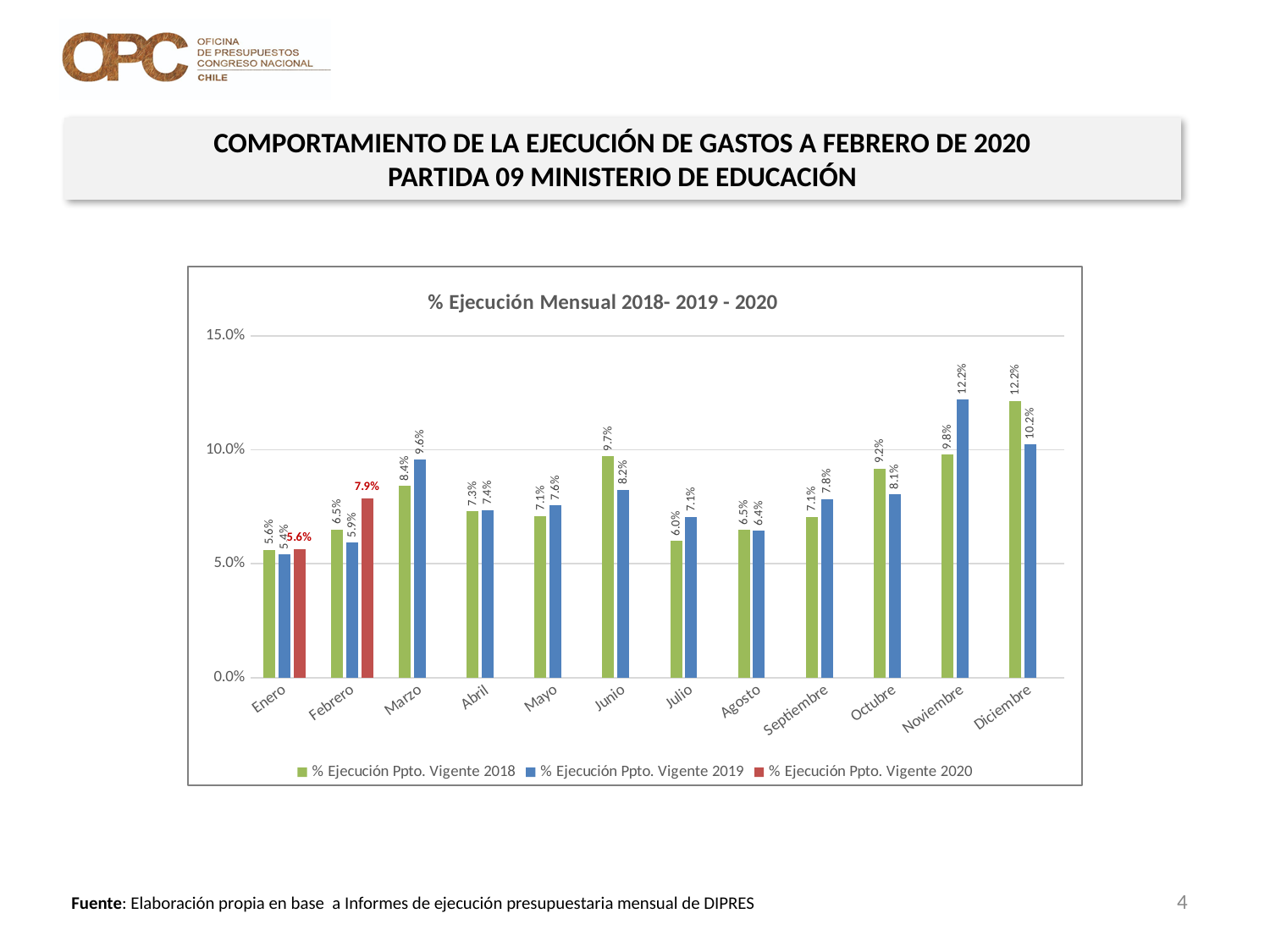
Which month has the lowest value for % Ejecución Ppto. Vigente 2019? Enero What kind of chart is shown on the slide? Bar chart What is the value for % Ejecución Ppto. Vigente 2018 in Junio? 9.7% What is the title of the chart? % Ejecución Mensual 2018- 2019 - 2020 What is the value for % Ejecución Ppto. Vigente 2020 in Febrero? 7.9% What is the difference between the 2019 and 2018 values in Marzo? 1.2% In Octubre, which series is larger: % Ejecución Ppto. Vigente 2018 or % Ejecución Ppto. Vigente 2019? % Ejecución Ppto. Vigente 2018 Which month has the highest value for % Ejecución Ppto. Vigente 2018? Diciembre Is the value for % Ejecución Ppto. Vigente 2019 in Diciembre greater or less than 10.0%? greater How many series does the legend list? 3 What is the value for % Ejecución Ppto. Vigente 2019 in Noviembre? 12.2% How many months are shown on the x axis? 12